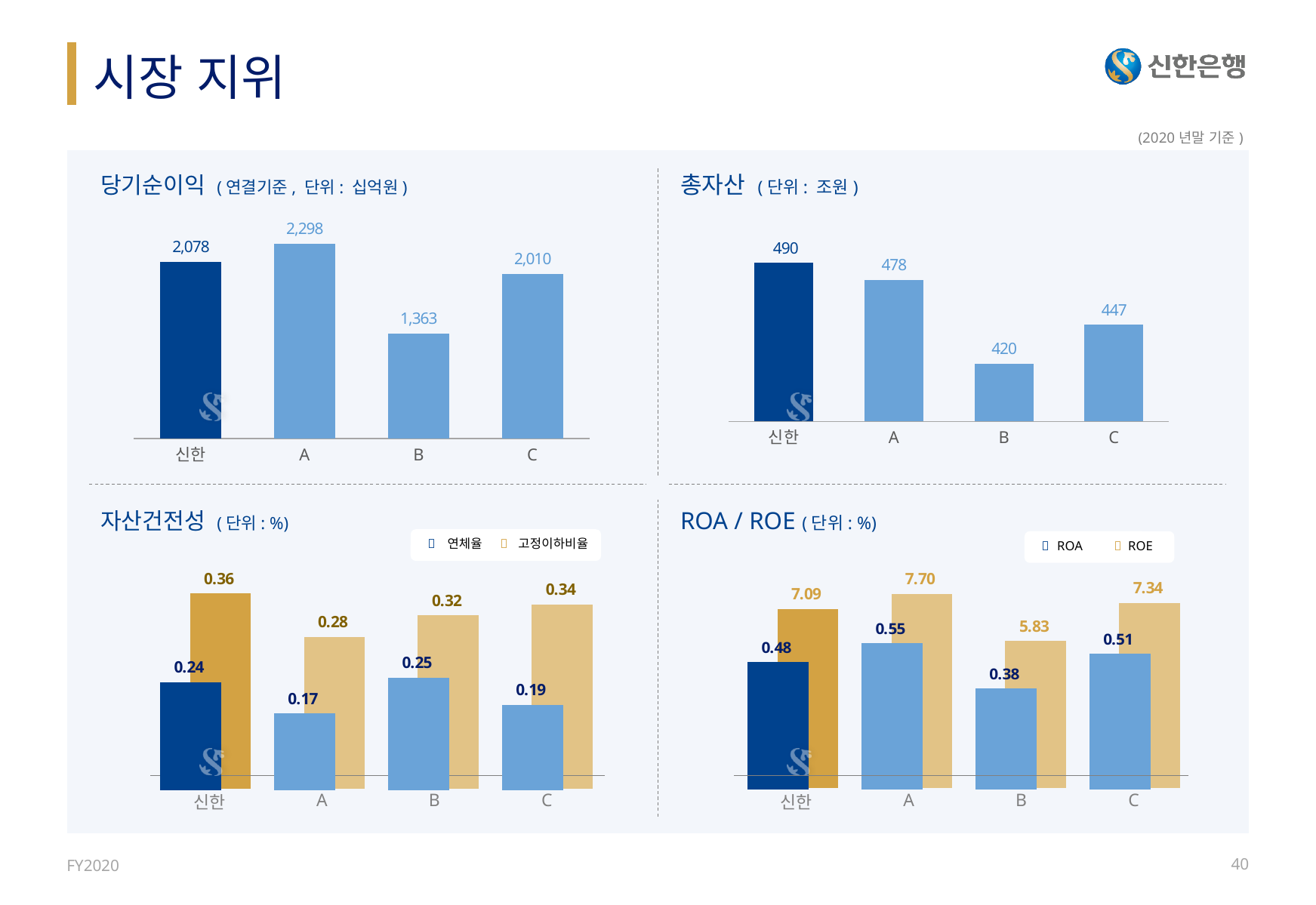
In the 당기순이익 chart, what is the value for 신한? 2,078 In the 자산건전성 chart, which category has the lowest 연체율? A In the 당기순이익 chart, which category has the highest value? A In the ROA / ROE chart, is the ROA for A larger or the ROA for C? A What kind of chart is the 총자산 chart? Bar chart In the 총자산 chart, what is the value for B? 420 In the 총자산 chart, which category has the lowest value? B In the ROA / ROE chart, what is the ROE value for B? 5.83 In the 자산건전성 chart, what is the 고정이하비율 value for 신한? 0.36 In the 총자산 chart, how many categories are shown? 4 In the 자산건전성 chart, how many series does the legend list? 2 In the 당기순이익 chart, what is the difference between A and B? 935